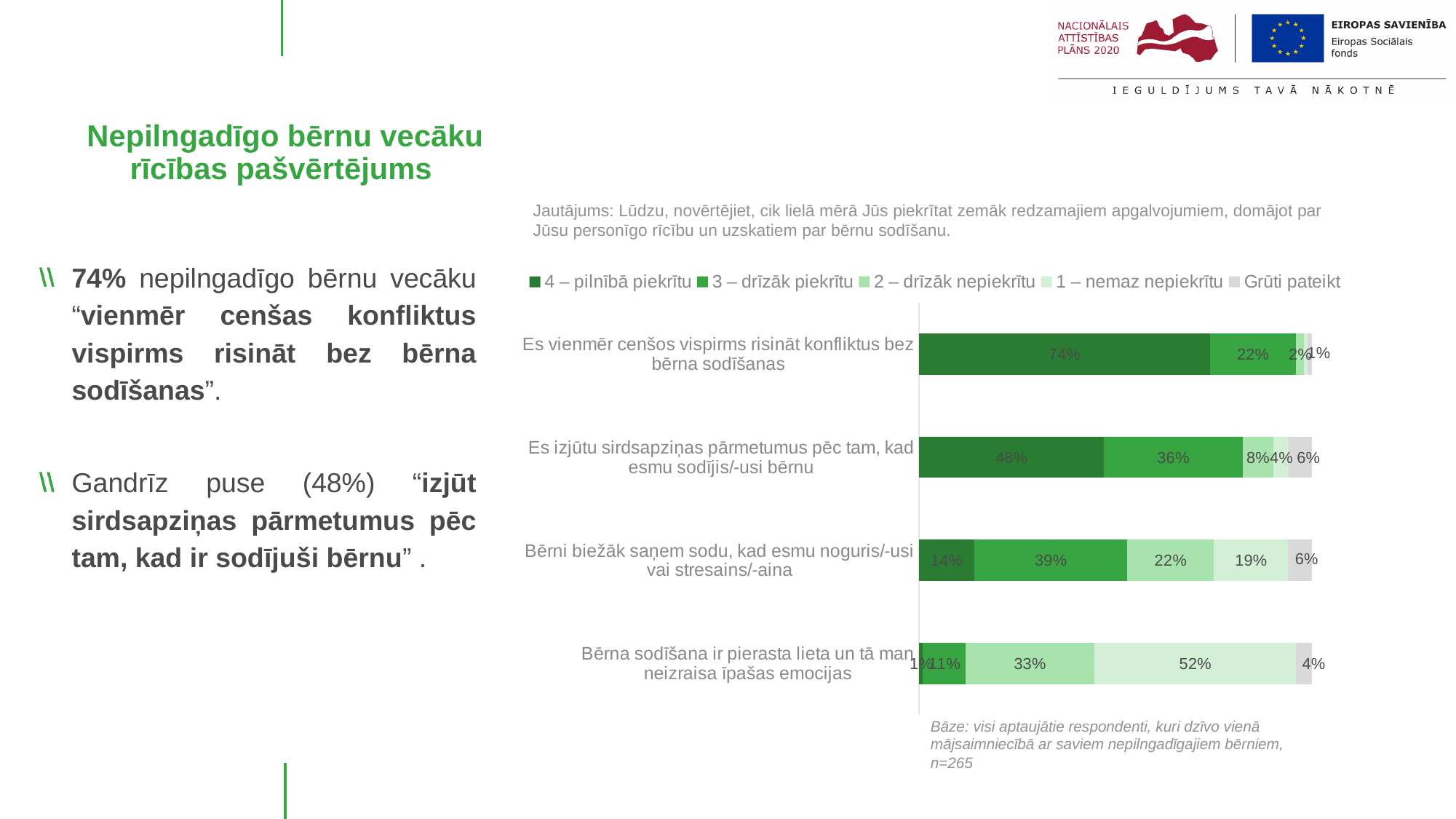
Which statement has the highest share of "4 – pilnībā piekrītu" answers? Es vienmēr cenšos vispirms risināt konfliktus bez bērna sodīšanas What is the sample size (n) stated in the base note below the chart? n=265 What share of respondents answered "1 – nemaz nepiekrītu" to the statement "Bērna sodīšana ir pierasta lieta un tā man neizraisa īpašas emocijas"? 52% What kind of chart is shown on the slide? stacked bar chart For the statement "Bērni biežāk saņem sodu, kad esmu noguris/-usi vai stresains/-aina", which is larger: the "3 – drīzāk piekrītu" share or the "2 – drīzāk nepiekrītu" share? 3 – drīzāk piekrītu What share of respondents answered "Grūti pateikt" to the statement "Bērni biežāk saņem sodu, kad esmu noguris/-usi vai stresains/-aina"? 6% Which statement has the lowest share of "4 – pilnībā piekrītu" answers? Bērna sodīšana ir pierasta lieta un tā man neizraisa īpašas emocijas How many statements (categories) are plotted in the chart? 4 What share of respondents answered "4 – pilnībā piekrītu" to the statement "Es vienmēr cenšos vispirms risināt konfliktus bez bērna sodīšanas"? 74% What is the difference between the "4 – pilnībā piekrītu" shares for "Es vienmēr cenšos vispirms risināt konfliktus bez bērna sodīšanas" and "Es izjūtu sirdsapziņas pārmetumus pēc tam, kad esmu sodījis/-usi bērnu"? 26% How many series does the chart legend list? 5 What share of respondents answered "3 – drīzāk piekrītu" to the statement "Es izjūtu sirdsapziņas pārmetumus pēc tam, kad esmu sodījis/-usi bērnu"? 36%